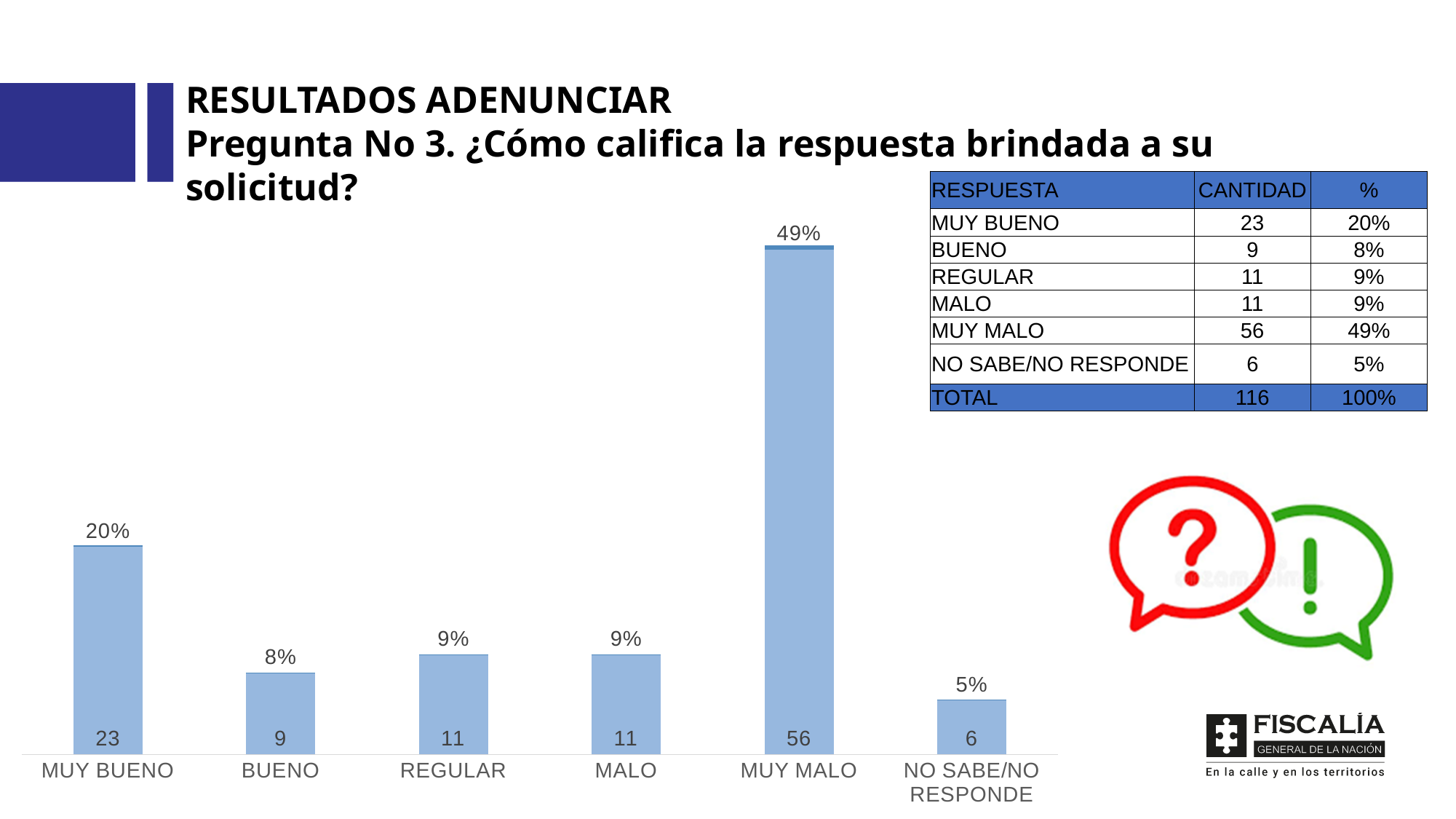
What percentage is shown for NO SABE/NO RESPONDE? 5% What percentage is shown for MUY MALO? 49% How many categories are shown on the x axis? 6 Which is larger, the value for MUY BUENO or the value for BUENO? MUY BUENO Which category has the lowest bar? NO SABE/NO RESPONDE What count is shown inside the bar for MUY BUENO? 23 Which category has the highest bar? MUY MALO What count is shown inside the bar for REGULAR? 11 What is the total count shown in the table (TOTAL row)? 116 What is the difference in percentage points between MUY MALO and MUY BUENO? 29 What is the difference between the counts for MUY MALO and BUENO? 47 What kind of chart is shown? bar chart